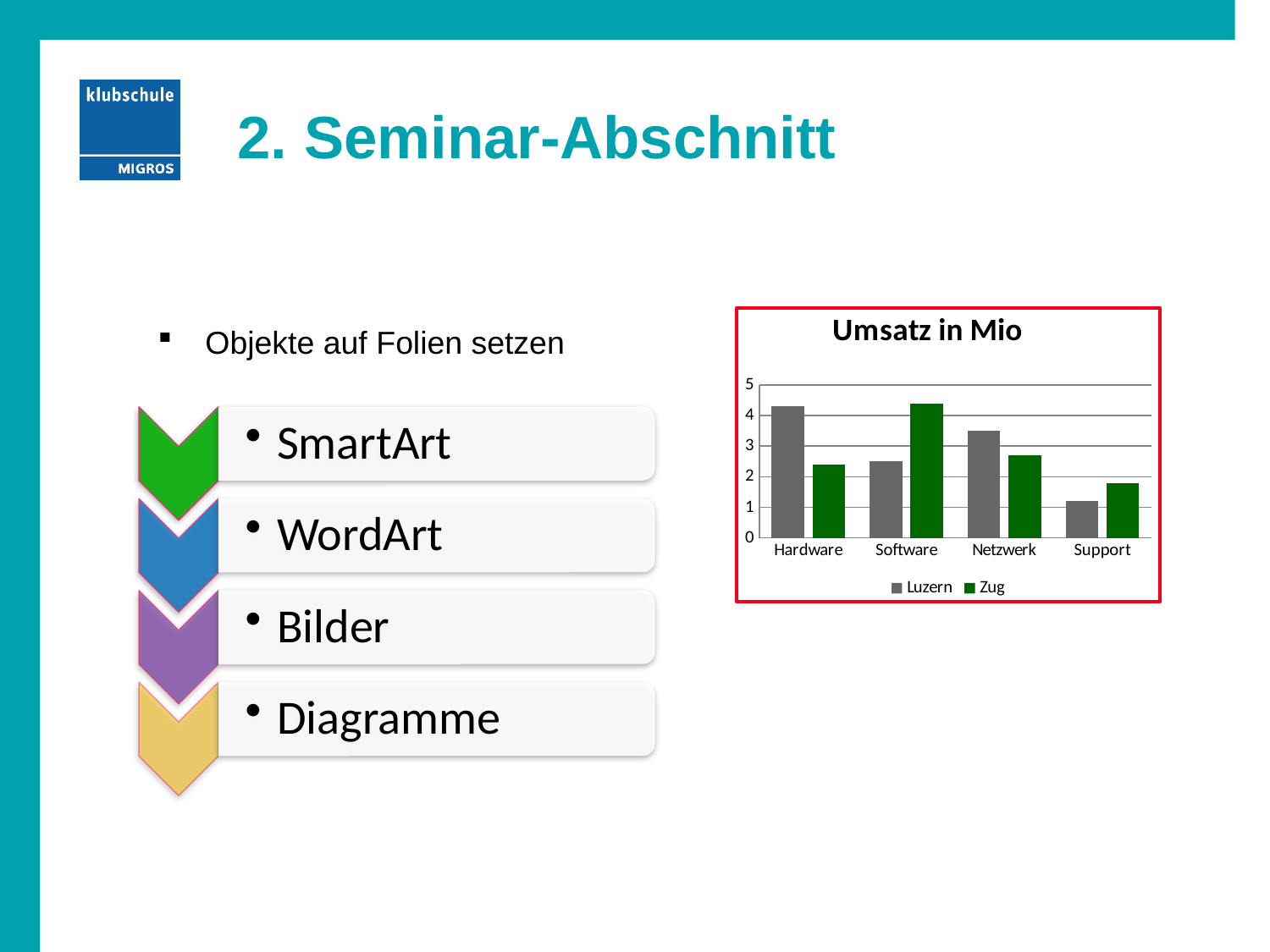
Is the Zug value for Hardware greater or less than 3? less How many categories are shown on the x axis of the chart? 4 Is the Luzern value for Hardware greater or less than 4? greater For the Zug series, which category has the highest value? Software For Software, which series has the larger value, Luzern or Zug? Zug How many series does the chart's legend list? 2 For the Luzern series, which category has the lowest value? Support For the Luzern series, which category has the highest value? Hardware What is the title of the chart? Umsatz in Mio For Hardware, which series has the larger value, Luzern or Zug? Luzern What kind of chart is shown on the slide? bar chart Which series is shown in green in the chart? Zug